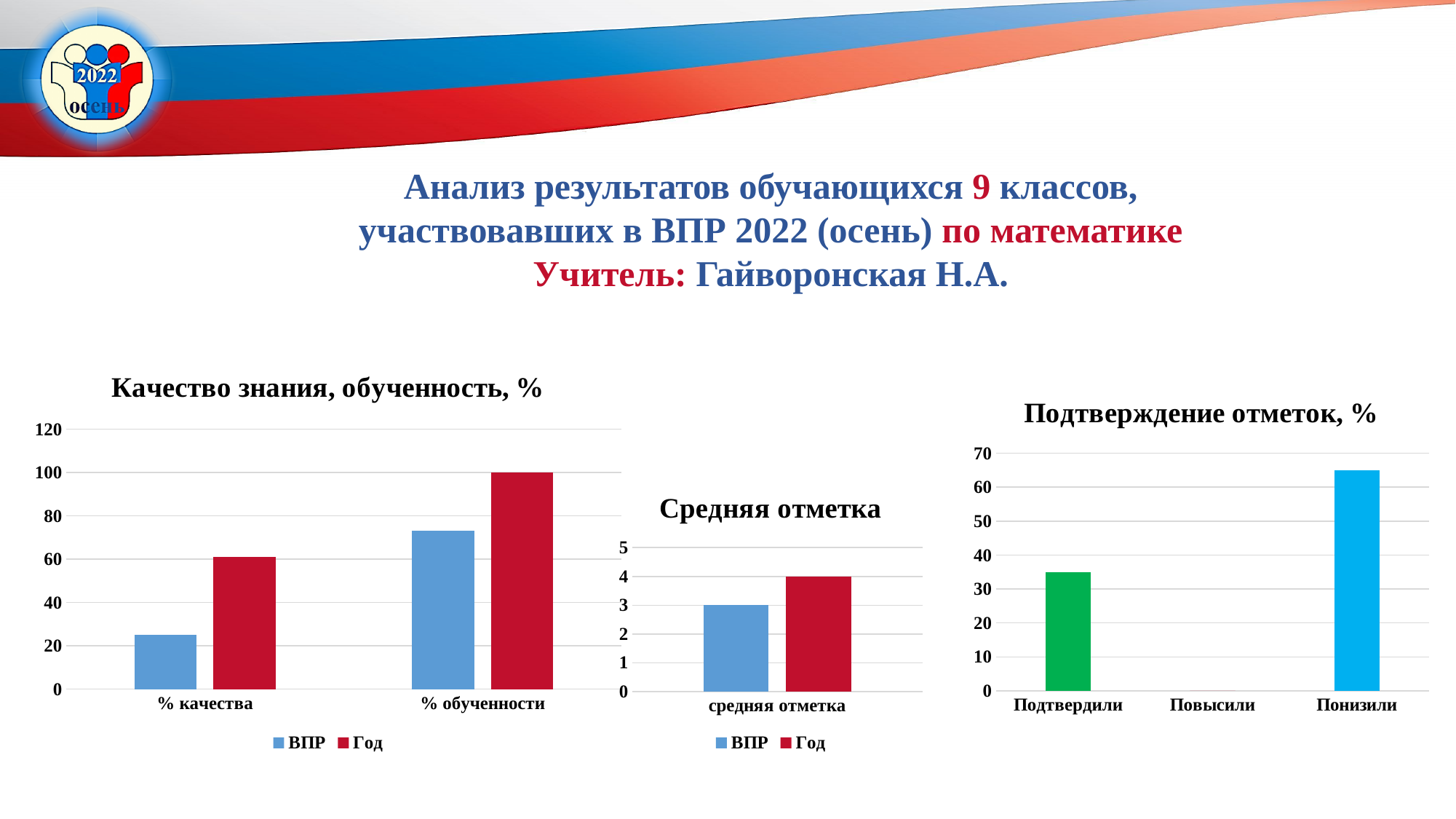
In the chart titled "Подтверждение отметок, %", which category has the highest value? Понизили In the chart titled "Качество знания, обученность, %", how many series does the legend list? 2 In the chart titled "Средняя отметка", what is the value for ВПР? 3 In the chart titled "Качество знания, обученность, %", is the ВПР value for % качества greater or less than 40? less What kind of chart is the chart titled "Подтверждение отметок, %"? bar chart In the chart titled "Подтверждение отметок, %", what is the value for Повысили? 0 In the chart titled "Качество знания, обученность, %", what is the Год value for % обученности? 100 In the chart titled "Качество знания, обученность, %", which series has the larger value for % обученности, ВПР or Год? Год In the chart titled "Подтверждение отметок, %", is the value for Подтвердили greater or less than 40? less In the chart titled "Средняя отметка", what is the value for Год? 4 In the chart titled "Средняя отметка", what is the difference between the Год value and the ВПР value? 1 In the chart titled "Подтверждение отметок, %", how many categories are shown on the x axis? 3